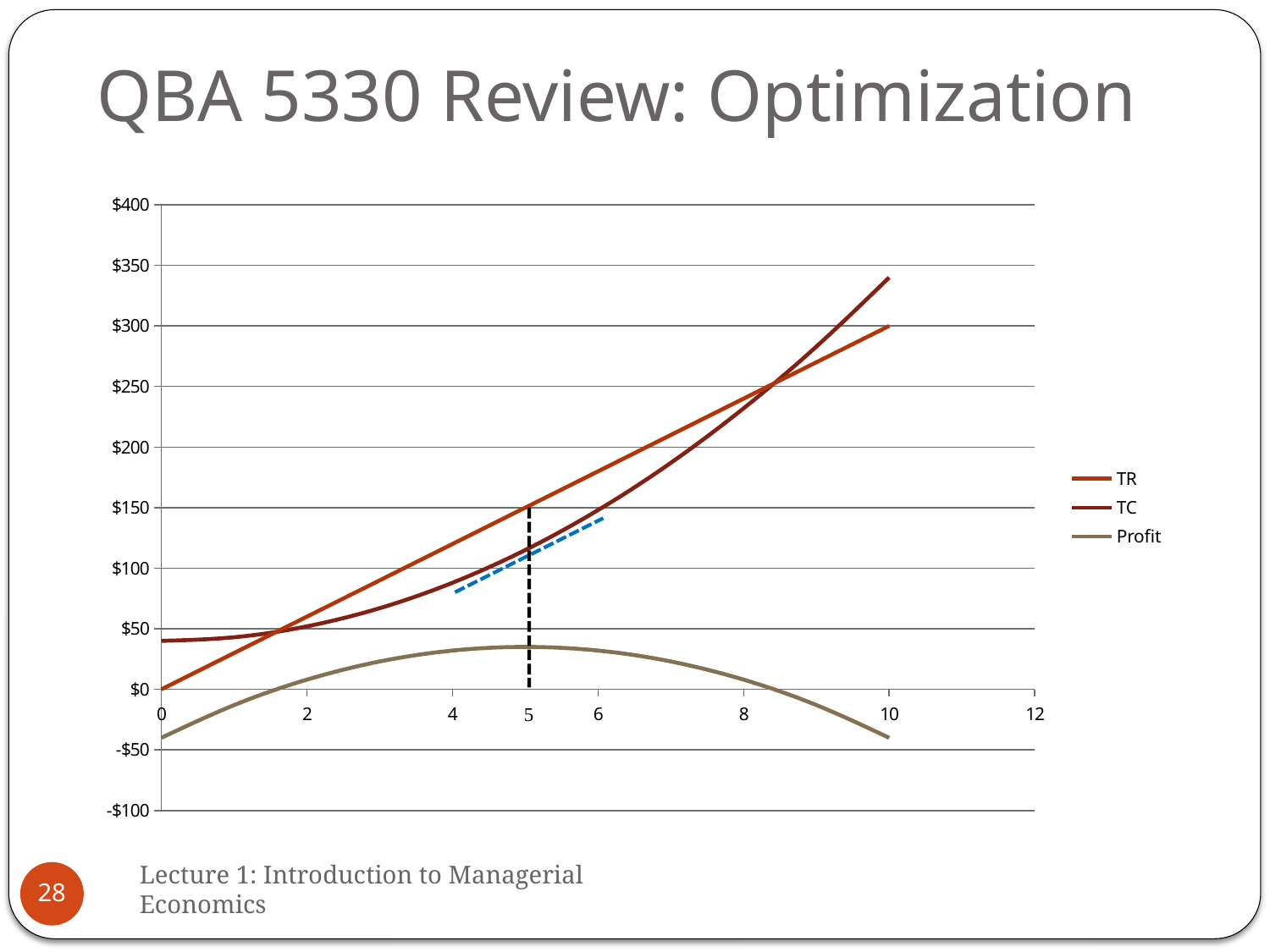
What is the value of TR at x = 0? $0 What are the three series named in the legend? TR, TC, Profit Is the value of TC at x = 0 greater or less than $50? less At x = 10, which series has the larger value, TR or TC? TC What is the value of TR at x = 10? $300 Does the TR line rise or fall as x increases? rises How many series does the legend list? 3 Is the value of Profit at x = 10 greater or less than $0? less Is the value of TC at x = 10 greater or less than $300? greater What is the value of TR at x = 5? $150 What kind of chart is shown on the slide? line chart At x = 5, which series has the larger value, TR or TC? TR